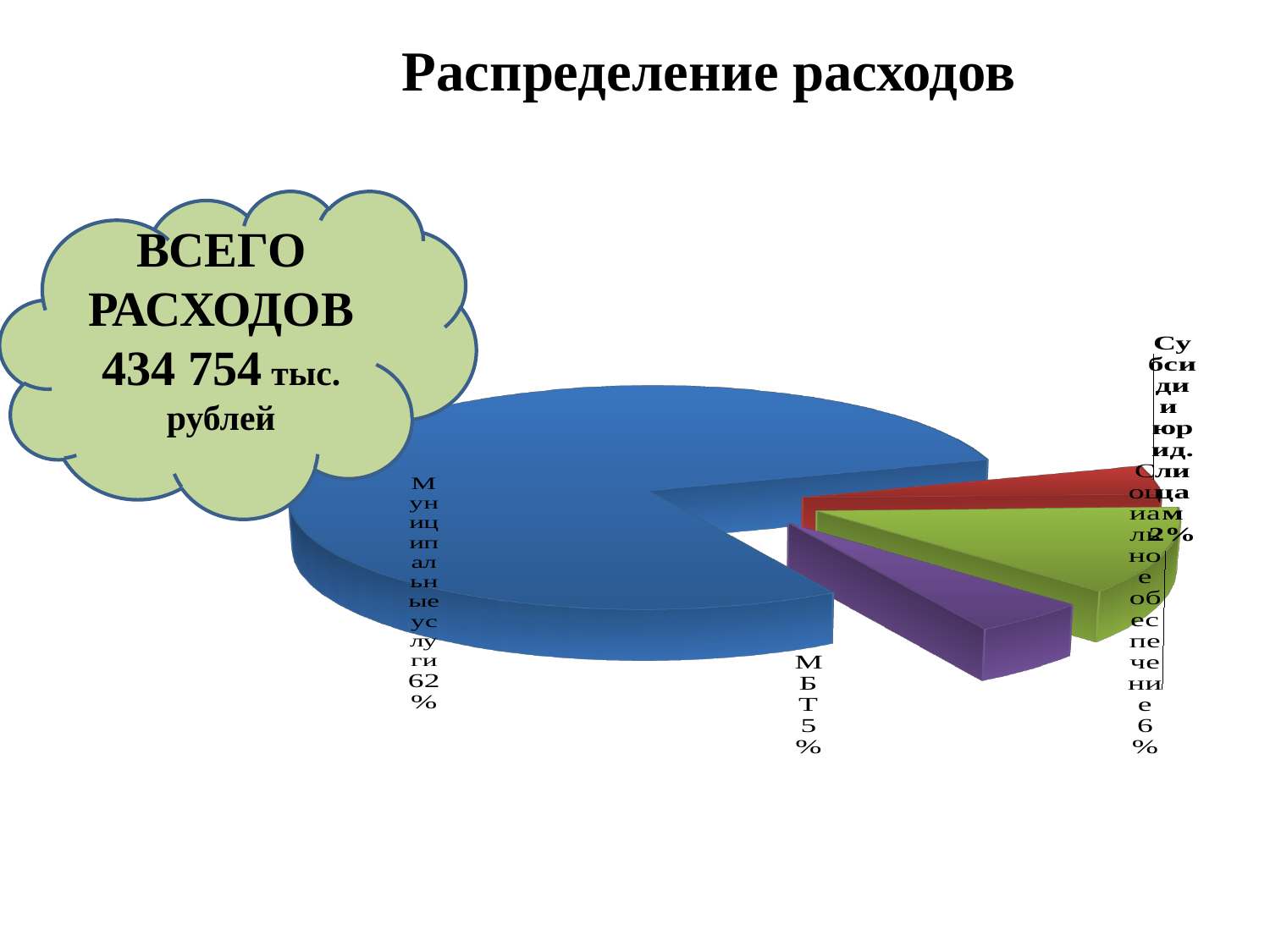
What share of expenses goes to МБТ? 5% What share of expenses goes to Субсидии юрид. лицам? 2% Which category has the largest share of expenses? Муниципальные услуги How many slices does the pie chart have? 4 What share of expenses goes to Социальное обеспечение? 6% What is the difference between the share for Муниципальные услуги and the share for Социальное обеспечение? 56% What kind of chart is shown on the slide? Pie chart Which is larger, the share for МБТ or the share for Социальное обеспечение? Социальное обеспечение What total amount of expenses is stated in the cloud callout on the slide? 434 754 тыс. рублей What is the title of the chart on the slide? Распределение расходов What share of expenses goes to Муниципальные услуги? 62% Which category has the smallest share of expenses? Субсидии юрид. лицам